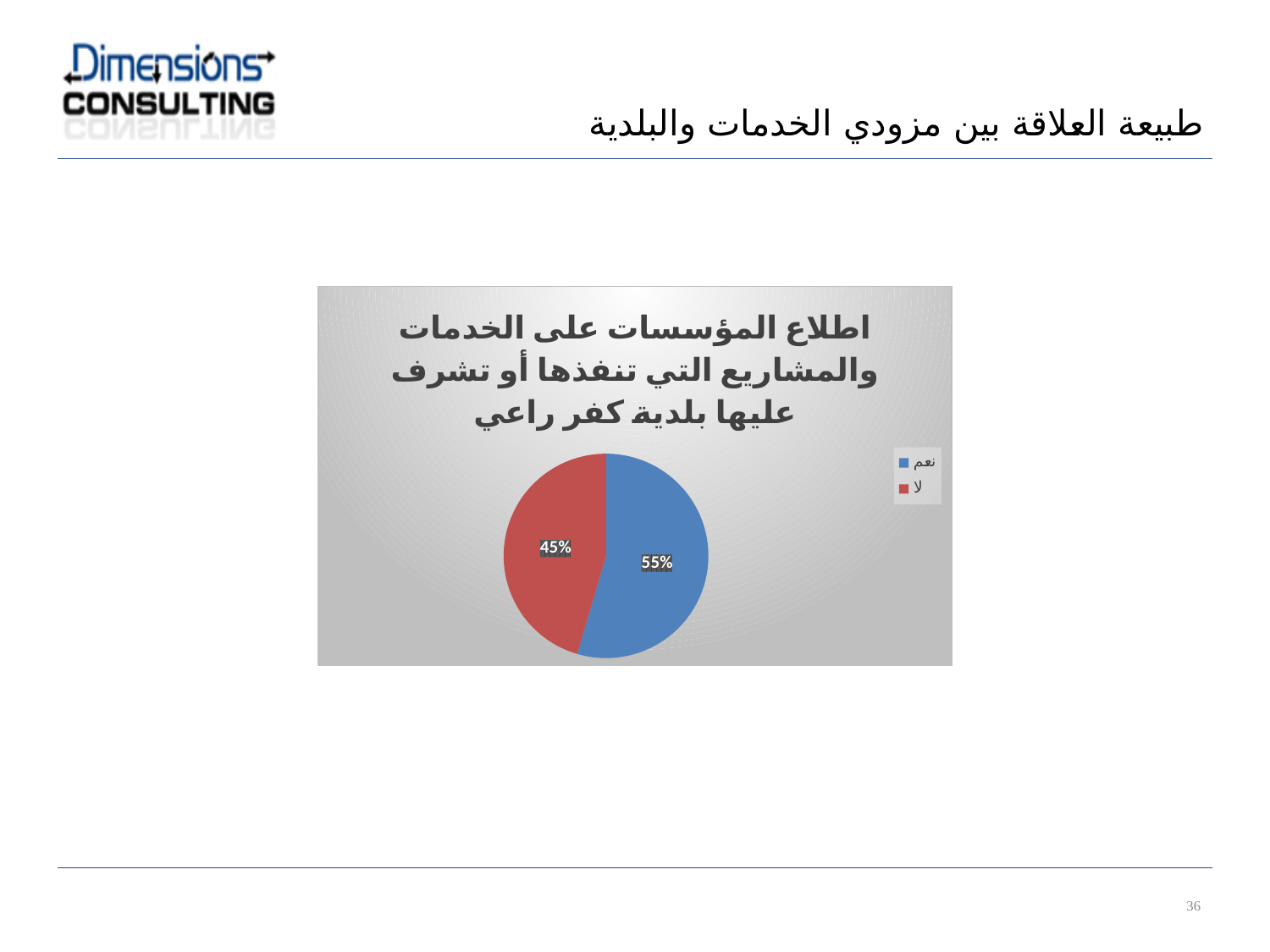
What share of the pie does the "نعم" slice represent? 55% Which is larger, the "نعم" slice or the "لا" slice? نعم What colour is the "نعم" slice in the pie chart? Blue Which slice is the smallest in the pie chart? لا What kind of chart is shown on the slide? Pie chart How many slices does the pie chart have? 2 Which slice is the largest in the pie chart? نعم What colour is the "لا" slice in the pie chart? Red What share of the pie does the "لا" slice represent? 45% How many entries does the legend list? 2 What is the difference in percentage points between the "نعم" slice and the "لا" slice? 10%